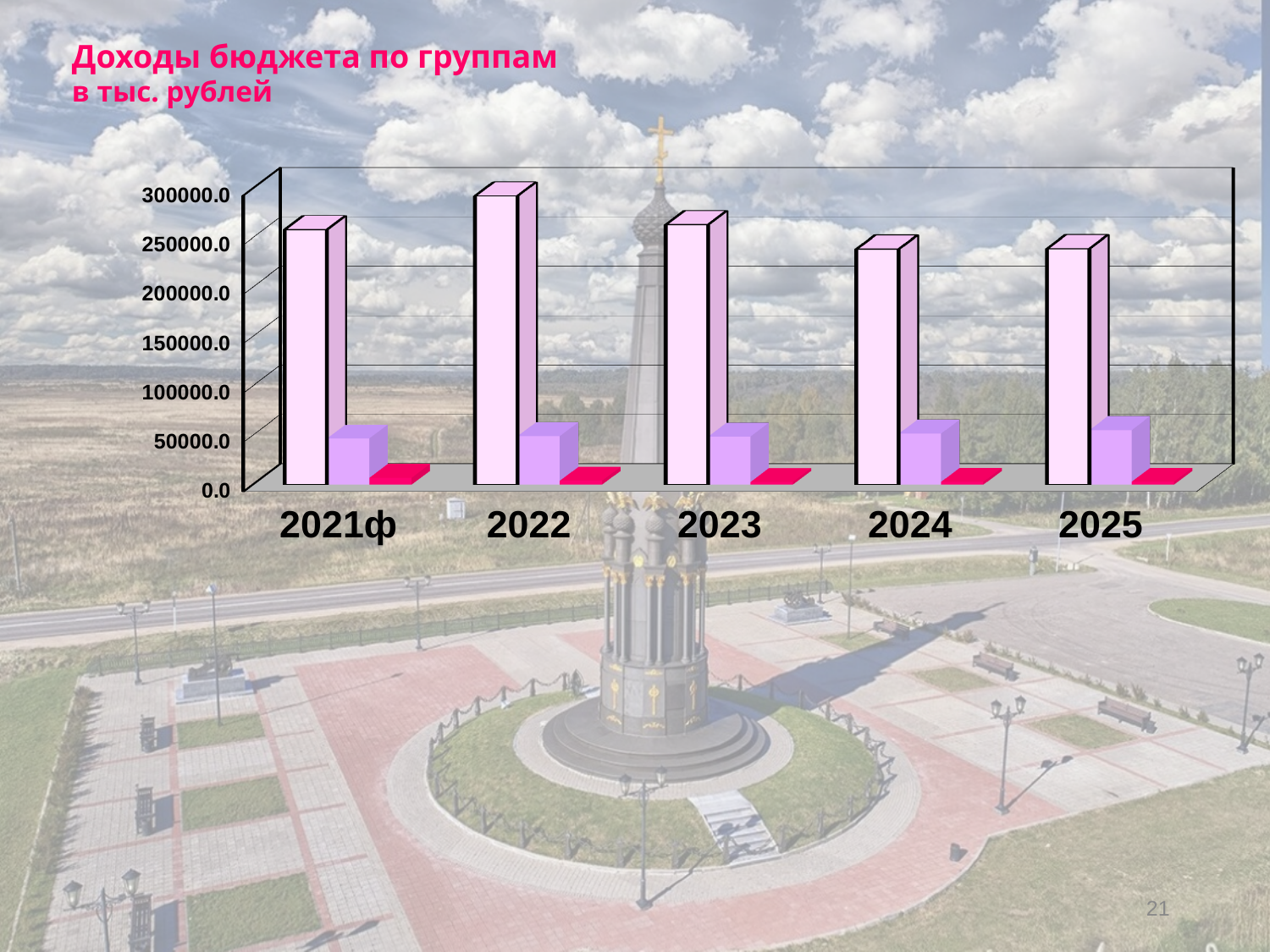
Is the tallest (light pink) bar for 2022 greater or less than 250000.0? greater Which light pink bar is taller, the one for 2022 or the one for 2024? 2022 What is the title of the chart on the slide? Доходы бюджета по группам в тыс. рублей What is the highest value shown on the vertical axis of the chart? 300000.0 Is the tallest (light pink) bar for 2024 greater or less than 200000.0? greater Which light pink bar is taller, the one for 2021ф or the one for 2025? 2021ф How many bars are plotted for each year category in the chart? 3 Which year has the tallest light pink bar in the chart? 2022 Is the magenta bar for 2025 greater or less than 50000.0? less How many categories are shown along the x axis of the chart? 5 What kind of chart is shown on the slide? bar chart